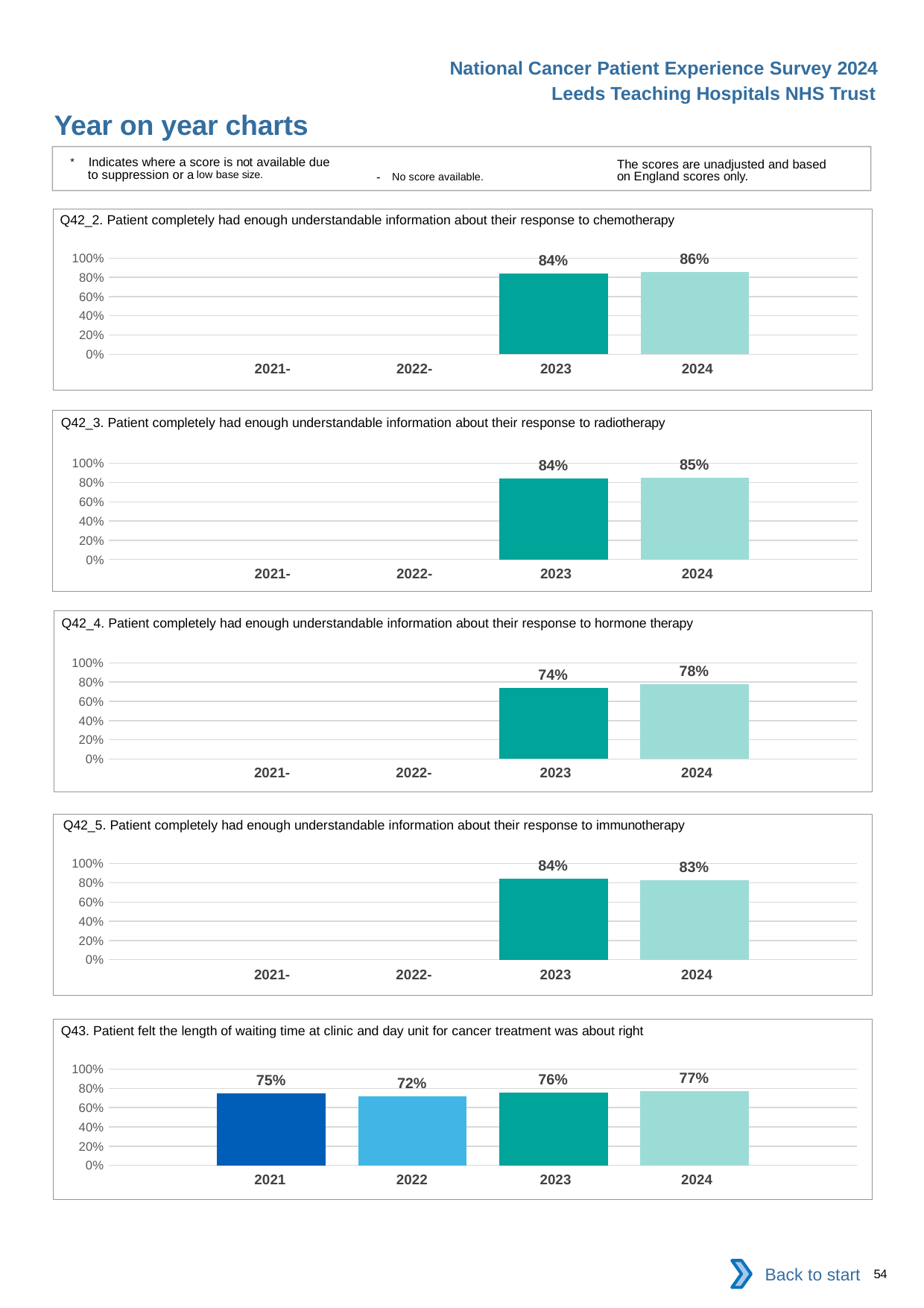
In the Q43 chart (waiting time at clinic and day unit), which year has the highest value? 2024 In the Q42_2 chart (chemotherapy), what is the value for 2024? 86% In the Q43 chart (waiting time at clinic and day unit), which year has the lowest value? 2022 In the Q42_4 chart (hormone therapy), is the value for 2023 greater or less than 80%? less In the Q43 chart (waiting time at clinic and day unit), what is the value for 2021? 75% In the Q42_3 chart (radiotherapy), what is the value for 2023? 84% In the Q43 chart (waiting time at clinic and day unit), what is the difference between the 2021 and 2022 values? 3% In the Q43 chart (waiting time at clinic and day unit), how many years have a bar plotted? 4 What kind of chart is the Q43 chart (waiting time at clinic and day unit)? Bar chart In the Q42_4 chart (hormone therapy), what is the difference between the 2024 and 2023 values? 4% In the Q42_5 chart (immunotherapy), which year has the higher value, 2023 or 2024? 2023 In the Q42_2 chart (chemotherapy), how many years have a bar plotted? 2